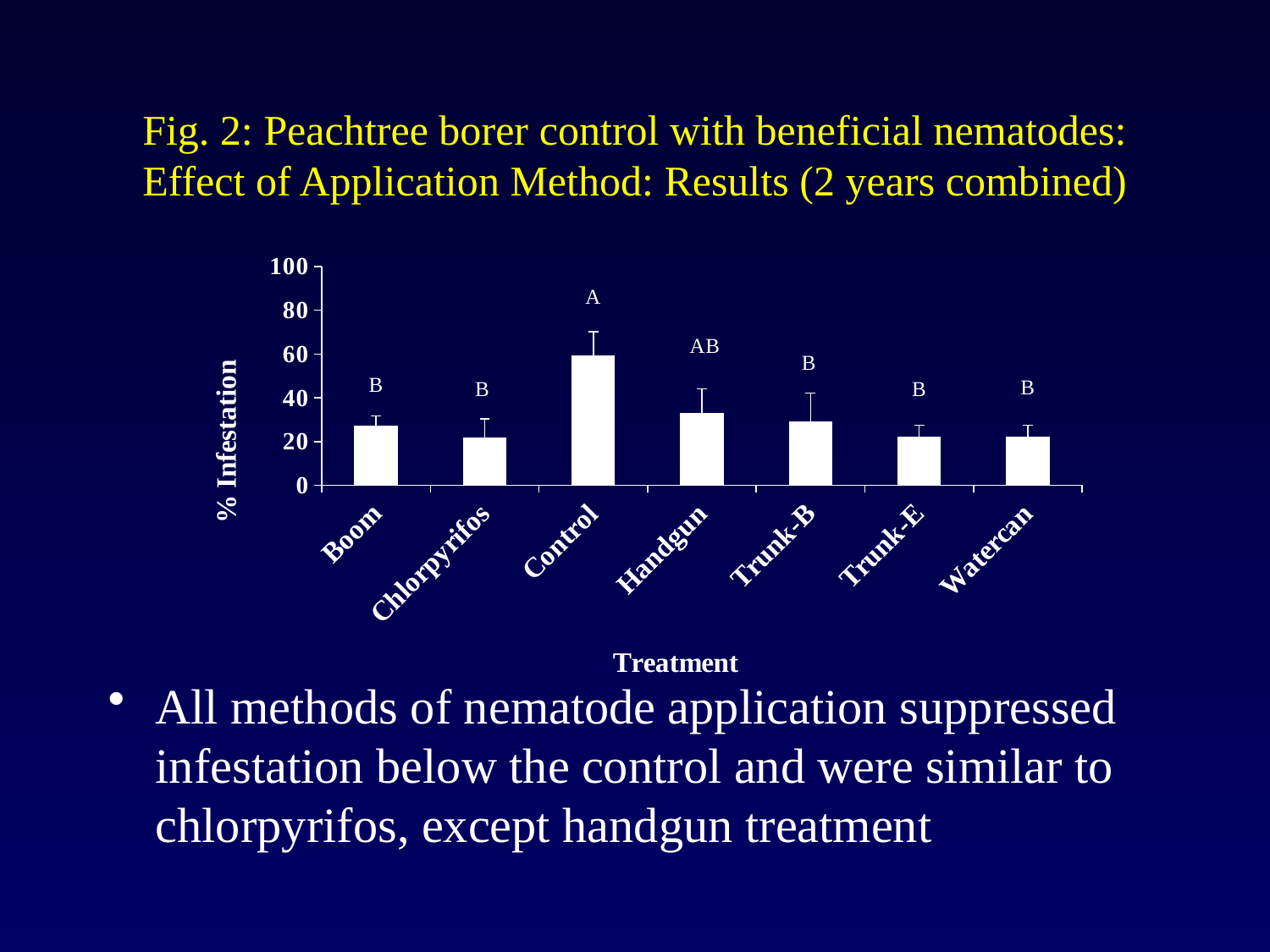
What is the title of the x axis of the chart? Treatment Is the % Infestation for Handgun greater or less than 60? less Is the % Infestation for Control greater or less than 80? less Which treatment has the highest % Infestation? Control Is the % Infestation for Boom greater or less than 40? less How many treatments are plotted on the x axis of the chart? 7 What letter label is printed above the Handgun bar? AB Which has a higher % Infestation, Control or Boom? Control What kind of chart is shown on the slide? bar chart Which has a higher % Infestation, Handgun or Chlorpyrifos? Handgun